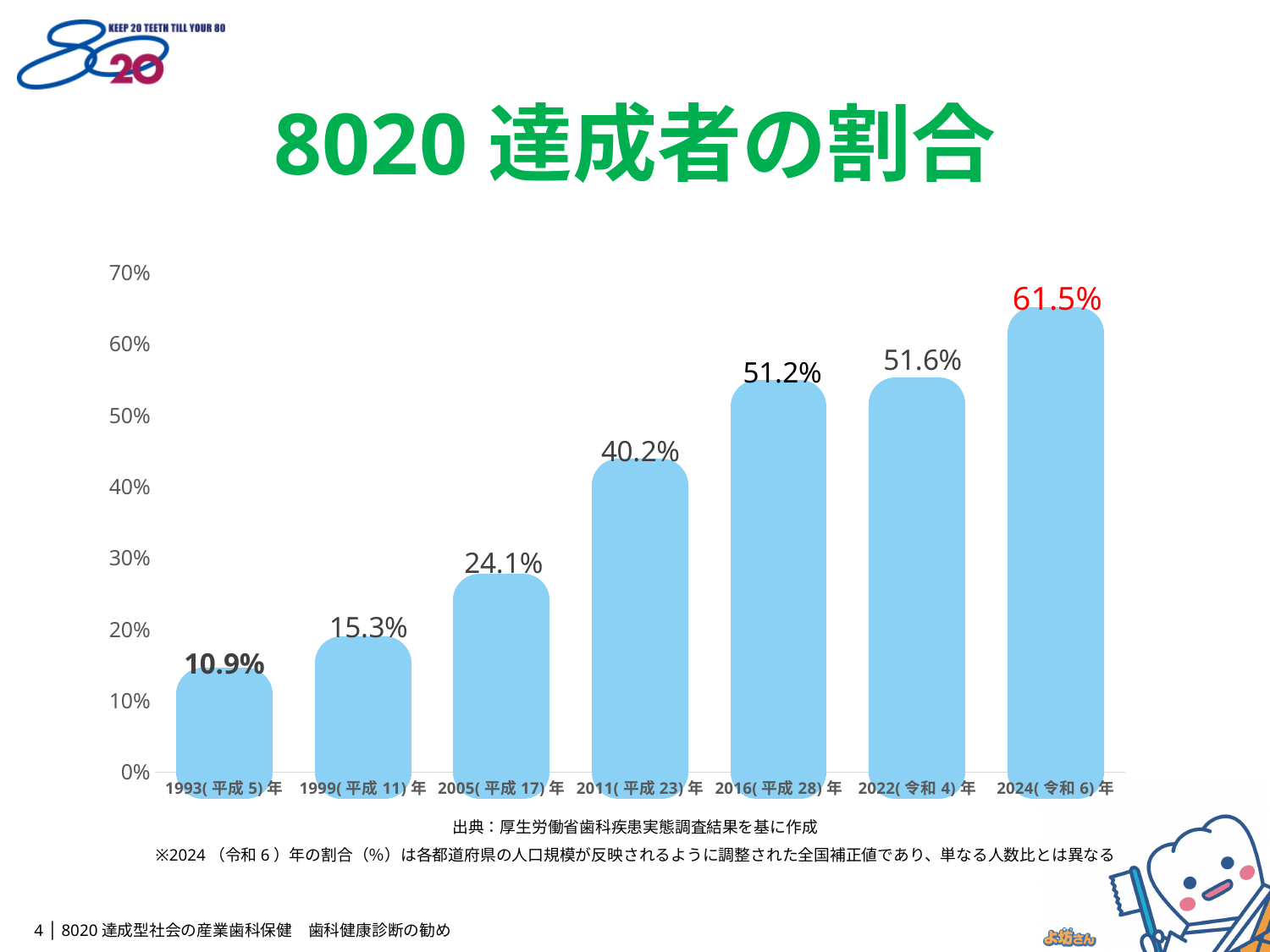
What is the difference between the values for 2024(令和6)年 and 1993(平成5)年? 50.6% Do the values rise or fall from 1993 to 2024? rise Is the value for 2022(令和4)年 greater or less than 50%? greater How many years are shown on the x axis? 7 What is the value for 2024(令和6)年? 61.5% What is the value for 2011(平成23)年? 40.2% Which year has the lowest value? 1993(平成5)年 What is the difference between the values for 2005(平成17)年 and 1999(平成11)年? 8.8% Which year has the highest value? 2024(令和6)年 What is the value for 1993(平成5)年? 10.9% What kind of chart is shown on the slide? bar chart Which is larger, the value for 2016(平成28)年 or 2011(平成23)年? 2016(平成28)年